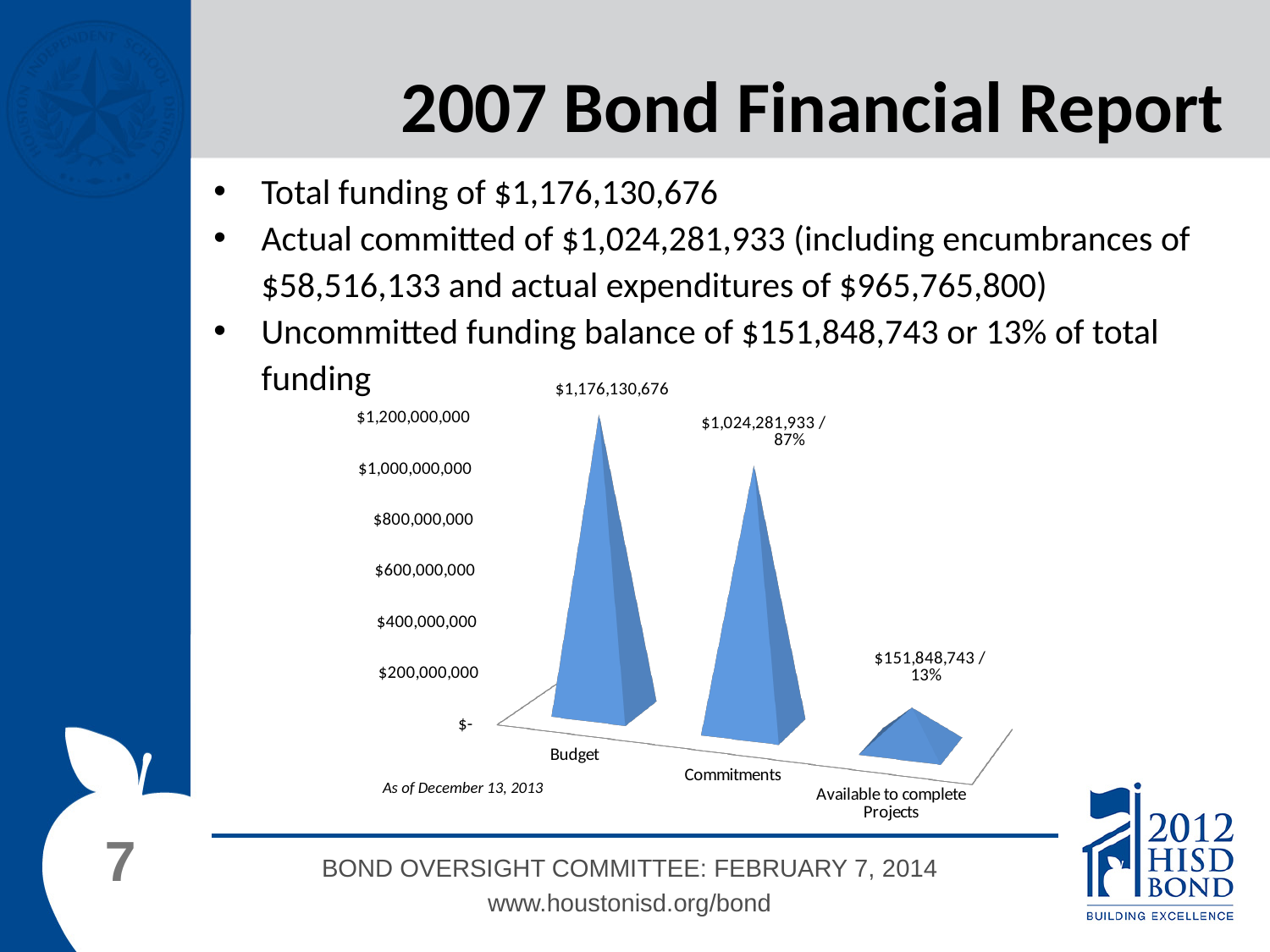
What is the value shown for Commitments? $1,024,281,933 What is the value shown for Available to complete Projects? $151,848,743 What is the difference between the Commitments value and the Available to complete Projects value? $872,433,190 Which category has the highest value? Budget What is the difference between the Budget value and the Commitments value? $151,848,743 How many categories are plotted on the chart? 3 What percentage is shown next to the Available to complete Projects value? 13% Which is larger, Commitments or Available to complete Projects? Commitments What date note appears below the chart? As of December 13, 2013 What is the value shown for Budget? $1,176,130,676 Which category has the lowest value? Available to complete Projects What percentage is shown next to the Commitments value? 87%